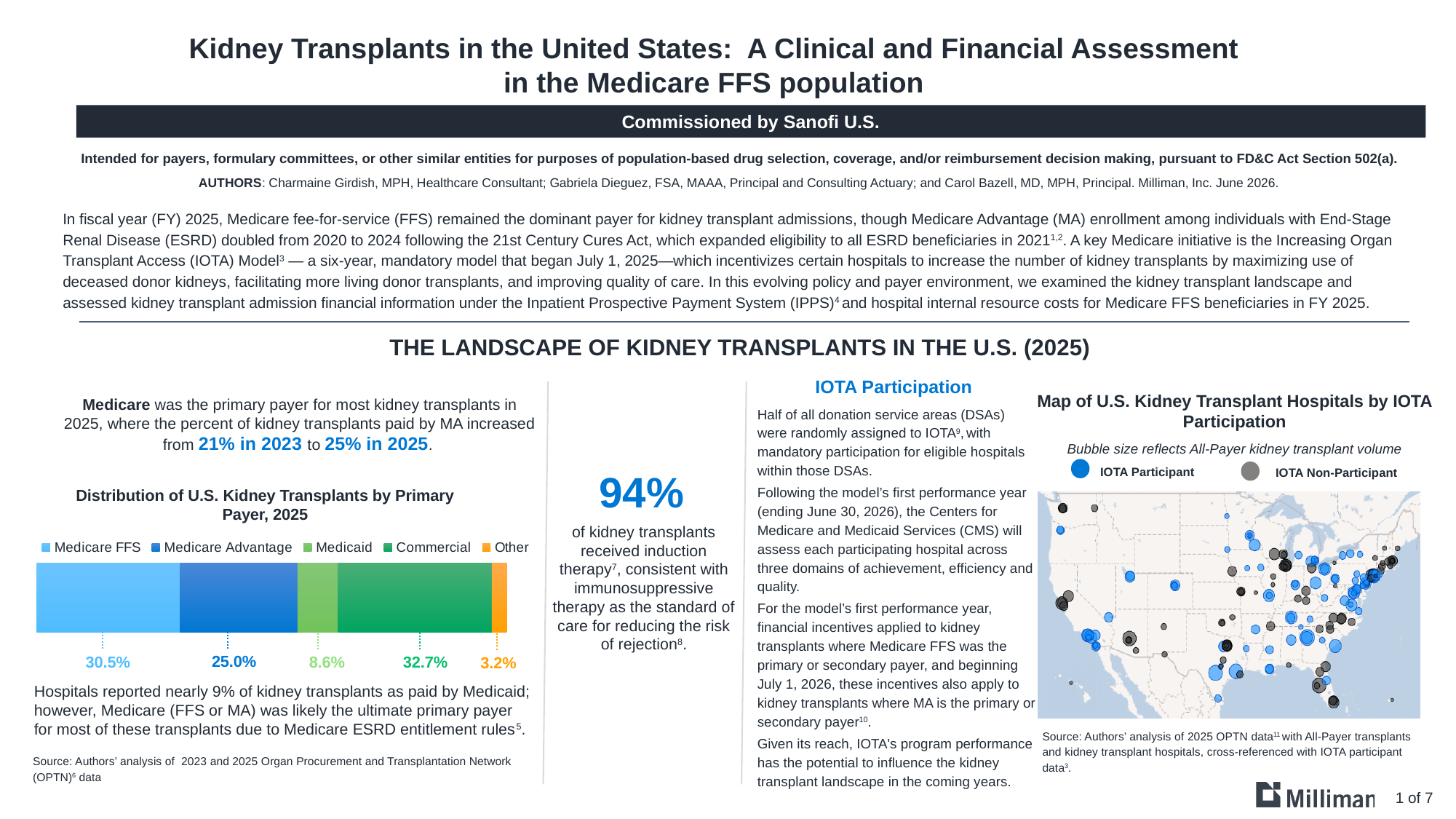
In the chart 'Distribution of U.S. Kidney Transplants by Primary Payer, 2025', what percentage of kidney transplants had Medicare FFS as the primary payer? 30.5% In the chart 'Distribution of U.S. Kidney Transplants by Primary Payer, 2025', how much larger is the Commercial share than the Medicare FFS share? 2.2% In the chart 'Distribution of U.S. Kidney Transplants by Primary Payer, 2025', which payer has the smallest share? Other In the chart 'Distribution of U.S. Kidney Transplants by Primary Payer, 2025', what is the value for Medicaid? 8.6% In the 'Map of U.S. Kidney Transplant Hospitals by IOTA Participation', what colour marks IOTA Participant hospitals? Blue How many payer categories does the legend of the chart 'Distribution of U.S. Kidney Transplants by Primary Payer, 2025' list? 5 In the chart 'Distribution of U.S. Kidney Transplants by Primary Payer, 2025', what is the value for Commercial? 32.7% In the chart 'Distribution of U.S. Kidney Transplants by Primary Payer, 2025', what is the difference between the Medicare FFS and Medicare Advantage shares? 5.5% In the chart 'Distribution of U.S. Kidney Transplants by Primary Payer, 2025', what is the total of all five payer shares? 100.0% What kind of chart is 'Distribution of U.S. Kidney Transplants by Primary Payer, 2025'? Stacked bar chart In the chart 'Distribution of U.S. Kidney Transplants by Primary Payer, 2025', which payer has the largest share? Commercial In the chart 'Distribution of U.S. Kidney Transplants by Primary Payer, 2025', which is larger: Medicare Advantage or Medicaid? Medicare Advantage